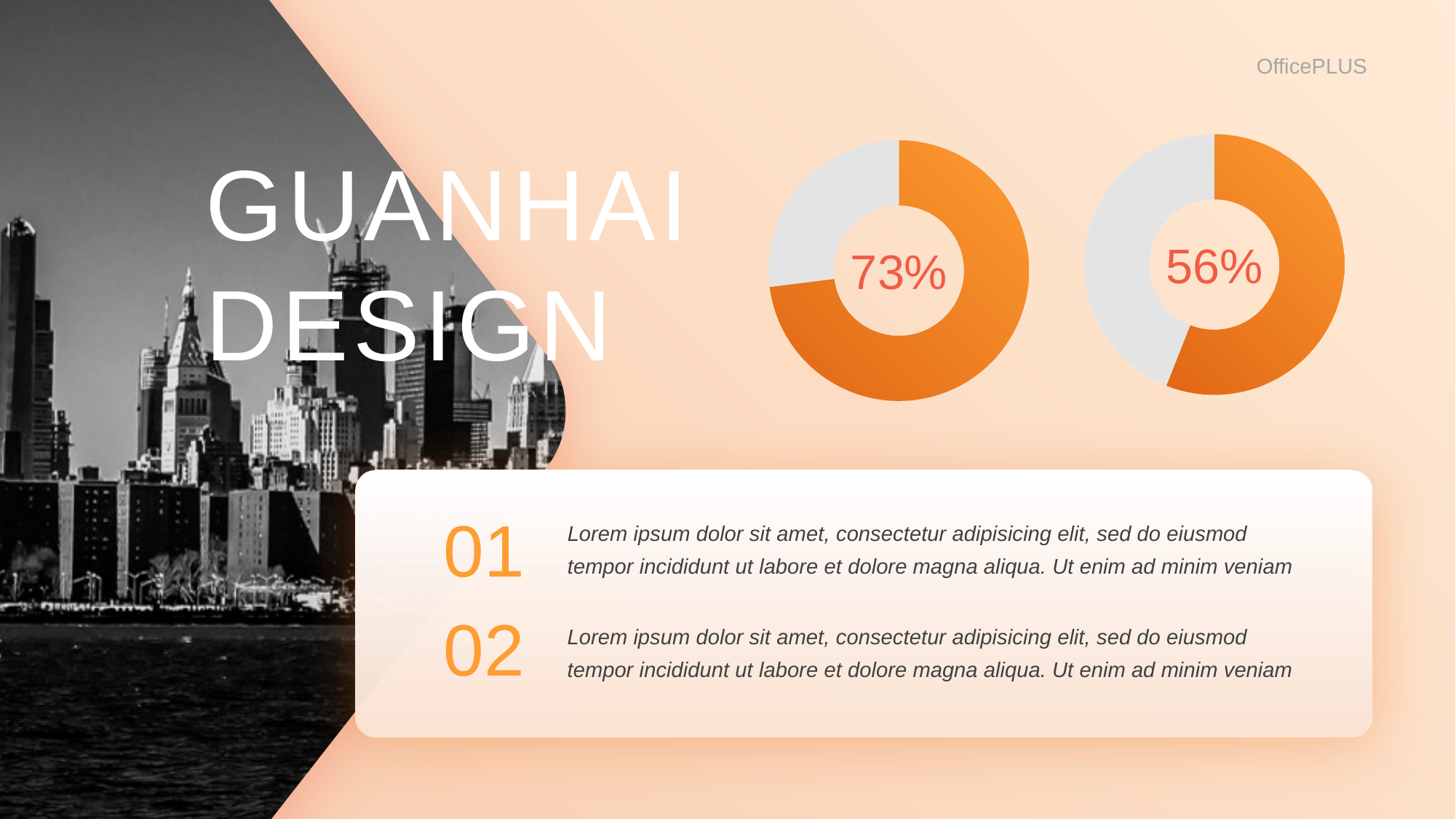
What colour is the filled portion of the donut charts? orange What percentage is shown in the centre of the left donut chart? 73% Is the percentage shown in the right donut chart greater or less than 60%? less Which donut chart shows the higher percentage, the left one or the right one? the left one What percentage is shown in the centre of the right donut chart? 56% How many donut charts are on the slide? 2 Which donut chart shows the lower percentage, the left one or the right one? the right one What kind of chart is used on the right side of the slide? donut chart Is the percentage shown in the left donut chart greater or less than 50%? greater What is the difference between the percentage in the left donut chart and the percentage in the right donut chart? 17% What colour is the unfilled remainder of the donut charts? light grey